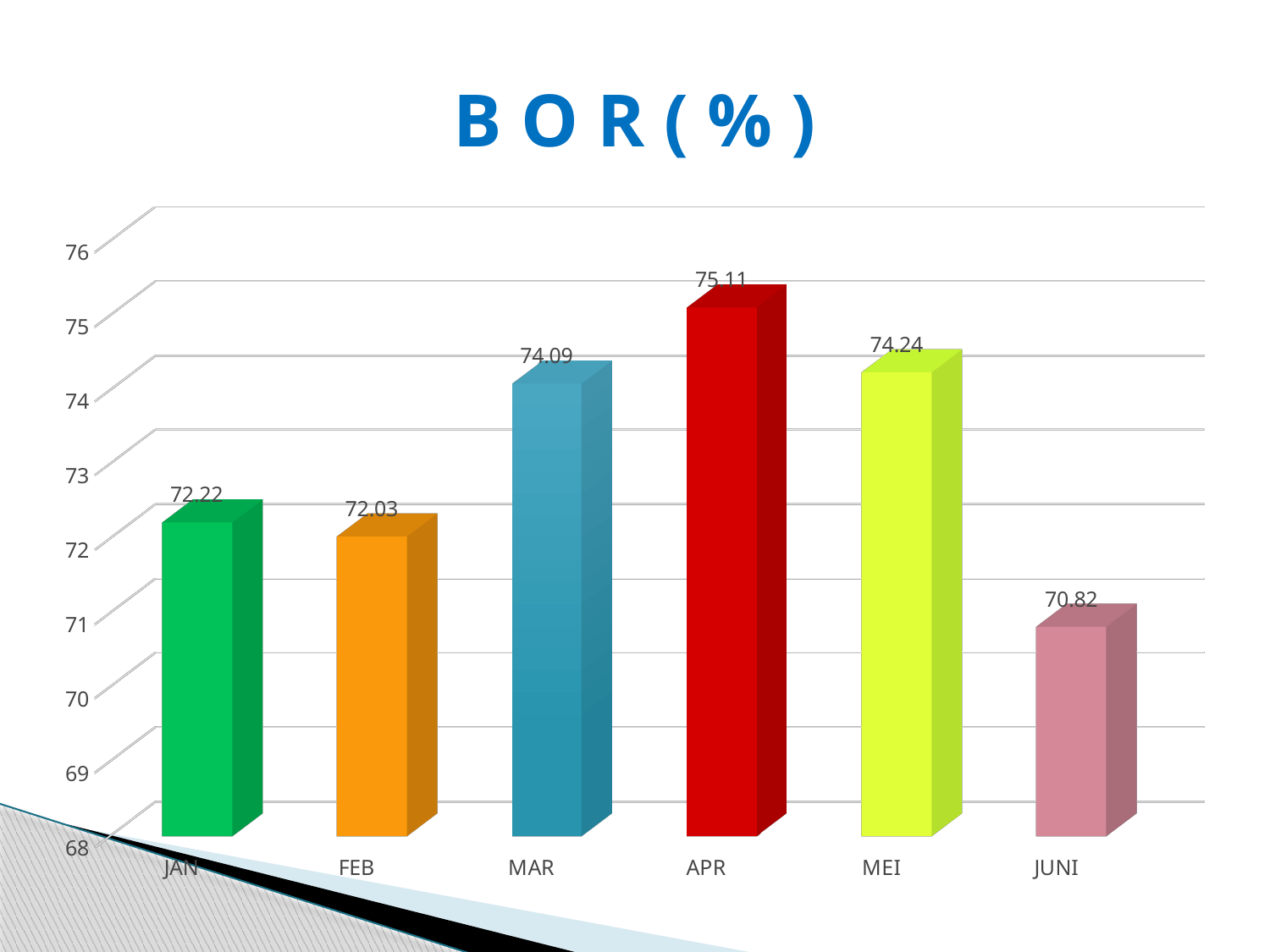
Which is larger, the BOR value for JAN or for MAR? MAR What is the difference between the BOR values for MEI and MAR? 0.15 What is the BOR value for JUNI? 70.82 What is the BOR value for MAR? 74.09 Is the BOR value for MEI greater or less than 74? greater What is the title of the chart? B O R ( % ) What is the BOR value for FEB? 72.03 How many months are shown on the chart? 6 What is the difference between the BOR values for APR and JUNI? 4.29 What kind of chart is shown on the slide? bar chart Which month has the highest BOR value? APR Which month has the lowest BOR value? JUNI